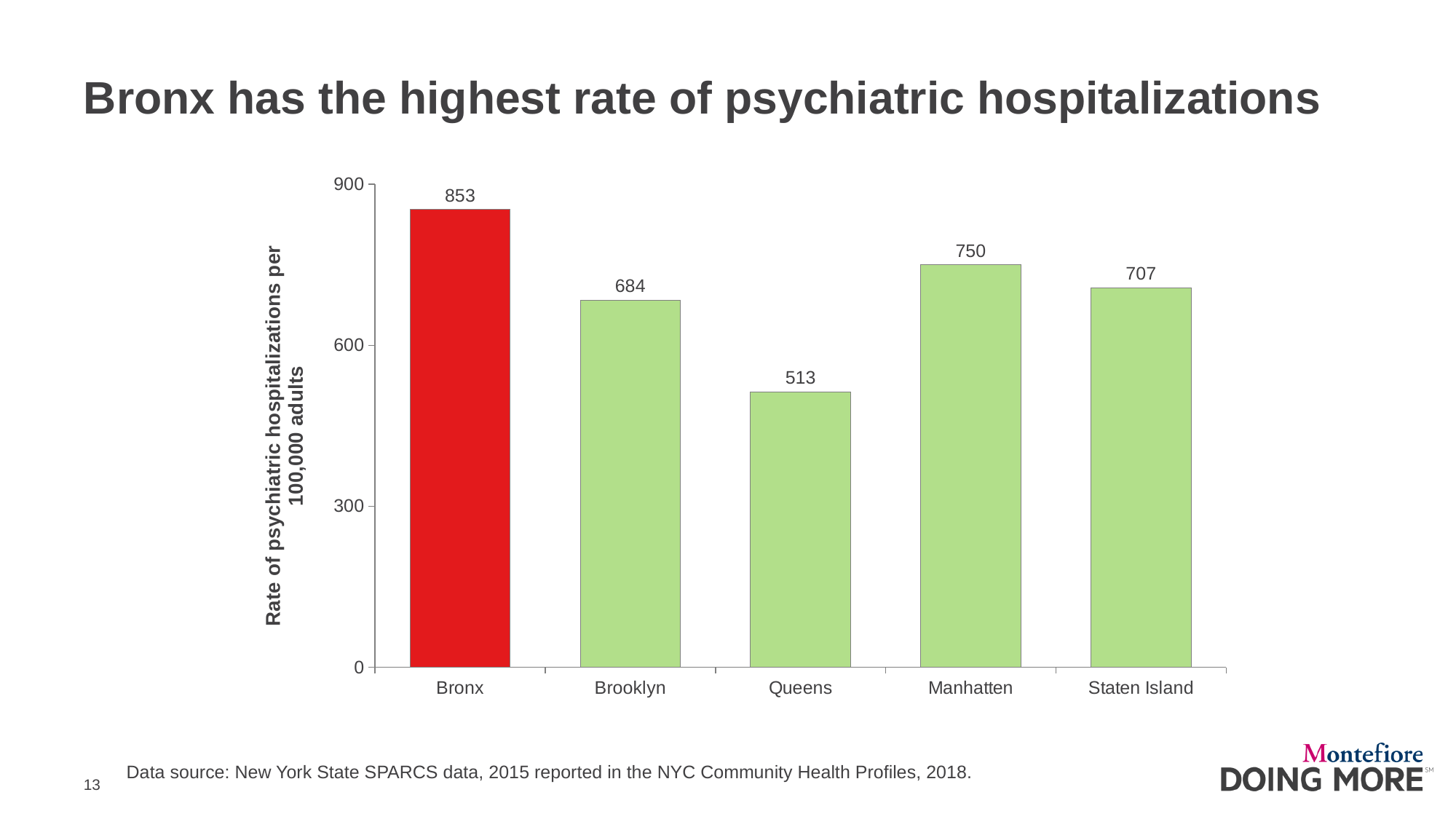
What is the rate of psychiatric hospitalizations per 100,000 adults for the Bronx? 853 Which bar on the chart is coloured red? Bronx How many boroughs are shown on the chart? 5 What is the difference between the Manhatten rate and the Queens rate of psychiatric hospitalizations? 237 What kind of chart is shown on the slide? Bar chart Which borough has the lowest rate of psychiatric hospitalizations? Queens What is the rate of psychiatric hospitalizations per 100,000 adults for Staten Island? 707 What is the rate of psychiatric hospitalizations per 100,000 adults for Queens? 513 What is the difference between the Bronx rate and the Brooklyn rate of psychiatric hospitalizations? 169 Is the value for Brooklyn greater or less than 600? greater Which borough has the highest rate of psychiatric hospitalizations? Bronx Which has a higher rate of psychiatric hospitalizations, Manhatten or Staten Island? Manhatten